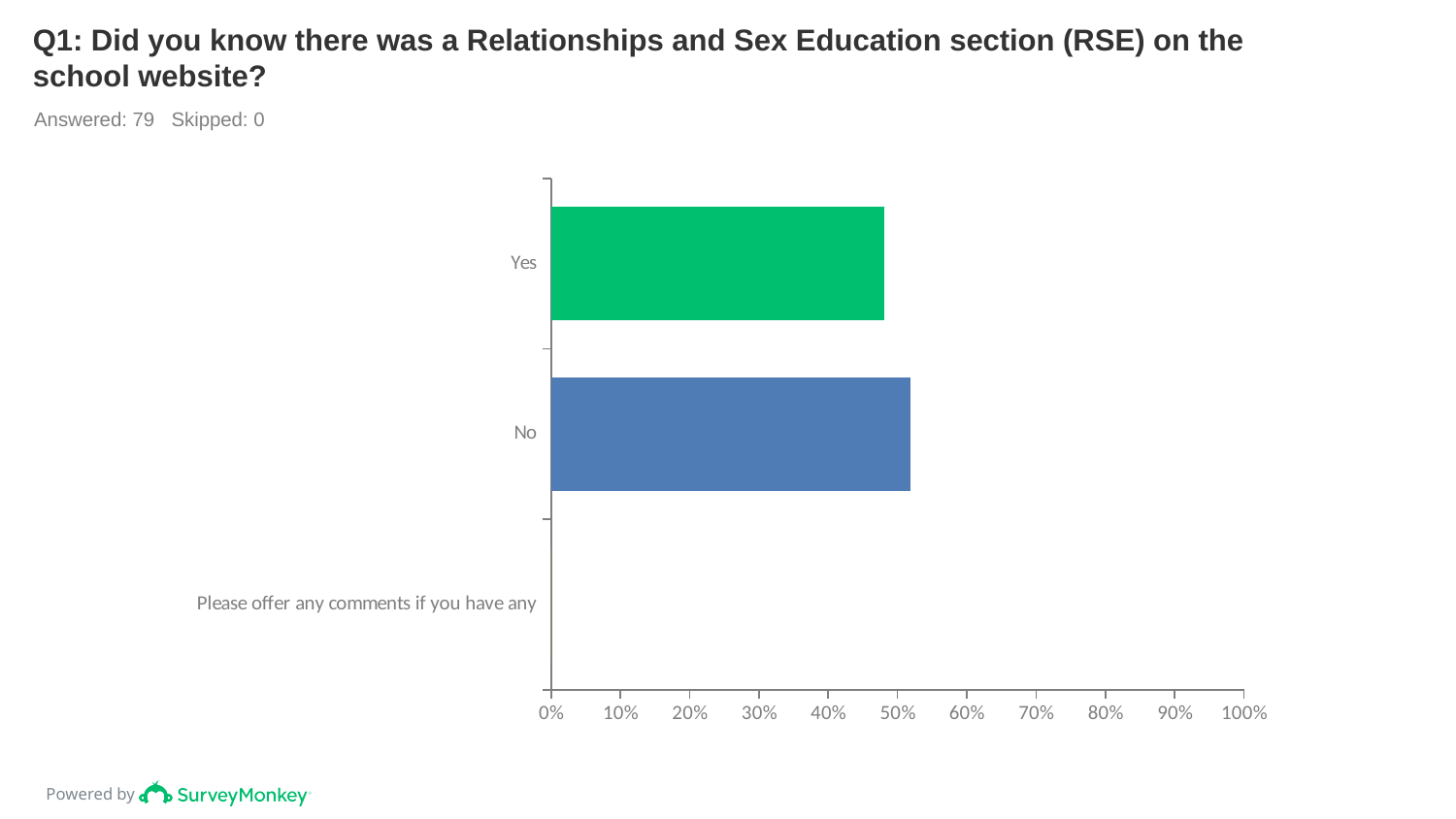
Is the value for Yes greater or less than 50%? less Is the value for No greater or less than 50%? greater Which category has the longest bar? No Which category has the lowest value? Please offer any comments if you have any Is the value for Yes greater or less than 40%? greater Which is larger, the value for Yes or the value for No? No How many categories are shown on the y axis of the chart? 3 What kind of chart is shown on the slide? Bar chart How many respondents answered this question according to the slide? 79 What is the highest value shown on the x axis? 100%